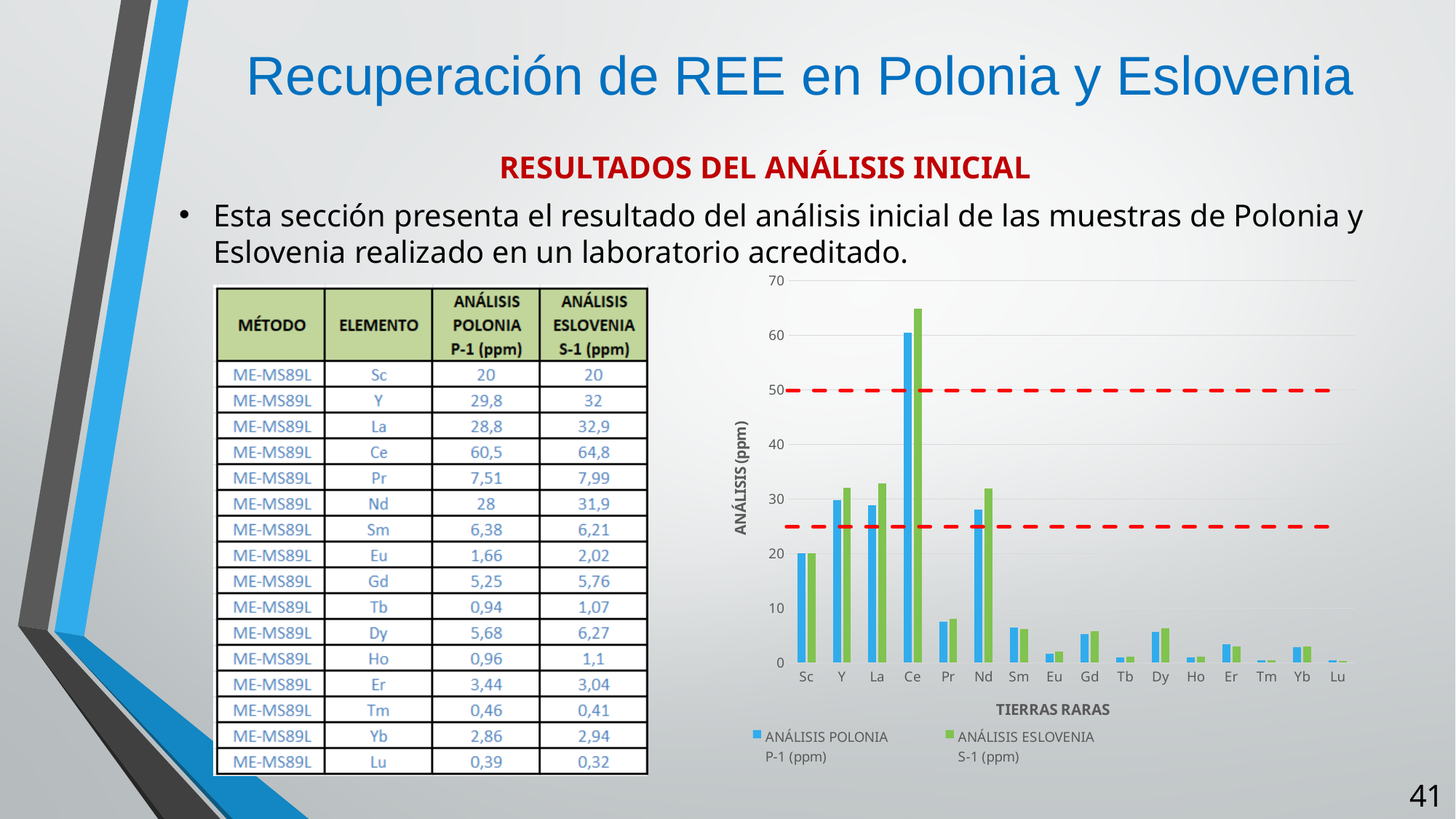
Which element has the highest ANÁLISIS ESLOVENIA S-1 (ppm) value in the chart? Ce What kind of chart is shown on the right of the slide? bar chart Is the ANÁLISIS POLONIA P-1 (ppm) value for Sc greater or less than 30? less Which element has the highest ANÁLISIS POLONIA P-1 (ppm) value in the chart? Ce According to the table on the slide, what is the ANÁLISIS POLONIA P-1 (ppm) value for Ce? 60,5 What is the title of the chart's x axis? TIERRAS RARAS For the ANÁLISIS POLONIA P-1 (ppm) series, which is larger: Nd or Sm? Nd How many series does the chart legend list? 2 How many rare earth elements are plotted along the x axis of the chart? 16 For Ce, which series has the larger value: ANÁLISIS POLONIA P-1 (ppm) or ANÁLISIS ESLOVENIA S-1 (ppm)? ANÁLISIS ESLOVENIA S-1 (ppm) Is the ANÁLISIS ESLOVENIA S-1 (ppm) value for Ce greater or less than 60? greater Using the values printed in the table, what is the difference between the ANÁLISIS ESLOVENIA S-1 (ppm) and ANÁLISIS POLONIA P-1 (ppm) values for Ce? 4,3